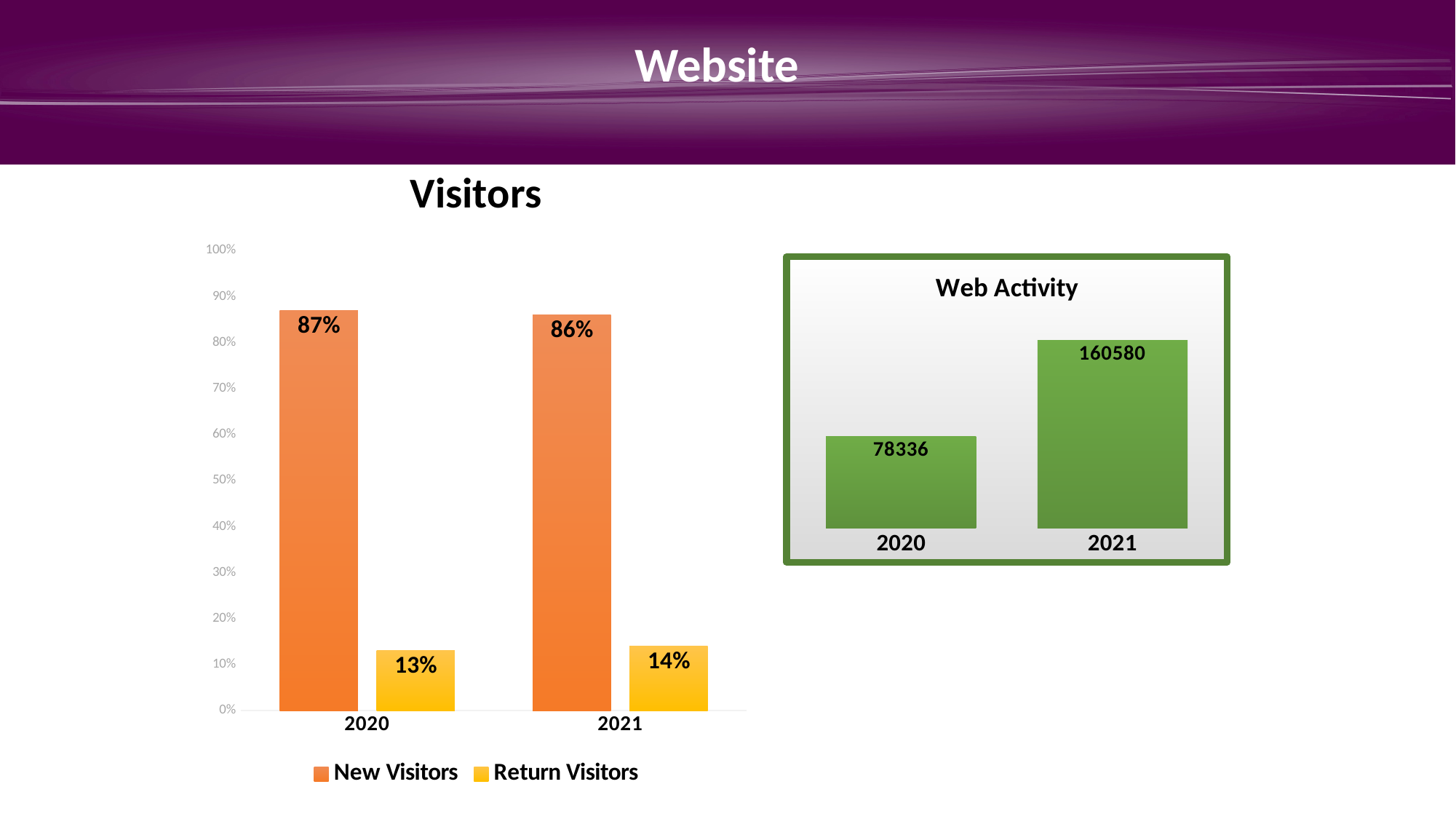
In the Web Activity chart, what is the value for 2020? 78336 In the Web Activity chart, what is the difference between the 2021 and 2020 values? 82244 In the Visitors chart, what is the value for New Visitors in 2020? 87% What kind of chart is the Web Activity chart? Bar chart In the Visitors chart, what colour are the Return Visitors bars? Yellow In the Web Activity chart, what is the value for 2021? 160580 How many categories are shown on the x axis of the Web Activity chart? 2 In the Web Activity chart, which year has the higher value? 2021 In the Visitors chart, what is the value for Return Visitors in 2021? 14% In the Visitors chart, which is larger: Return Visitors in 2020 or Return Visitors in 2021? Return Visitors in 2021 In the Visitors chart, what is the difference between New Visitors and Return Visitors in 2020? 74% How many series does the legend of the Visitors chart list? 2